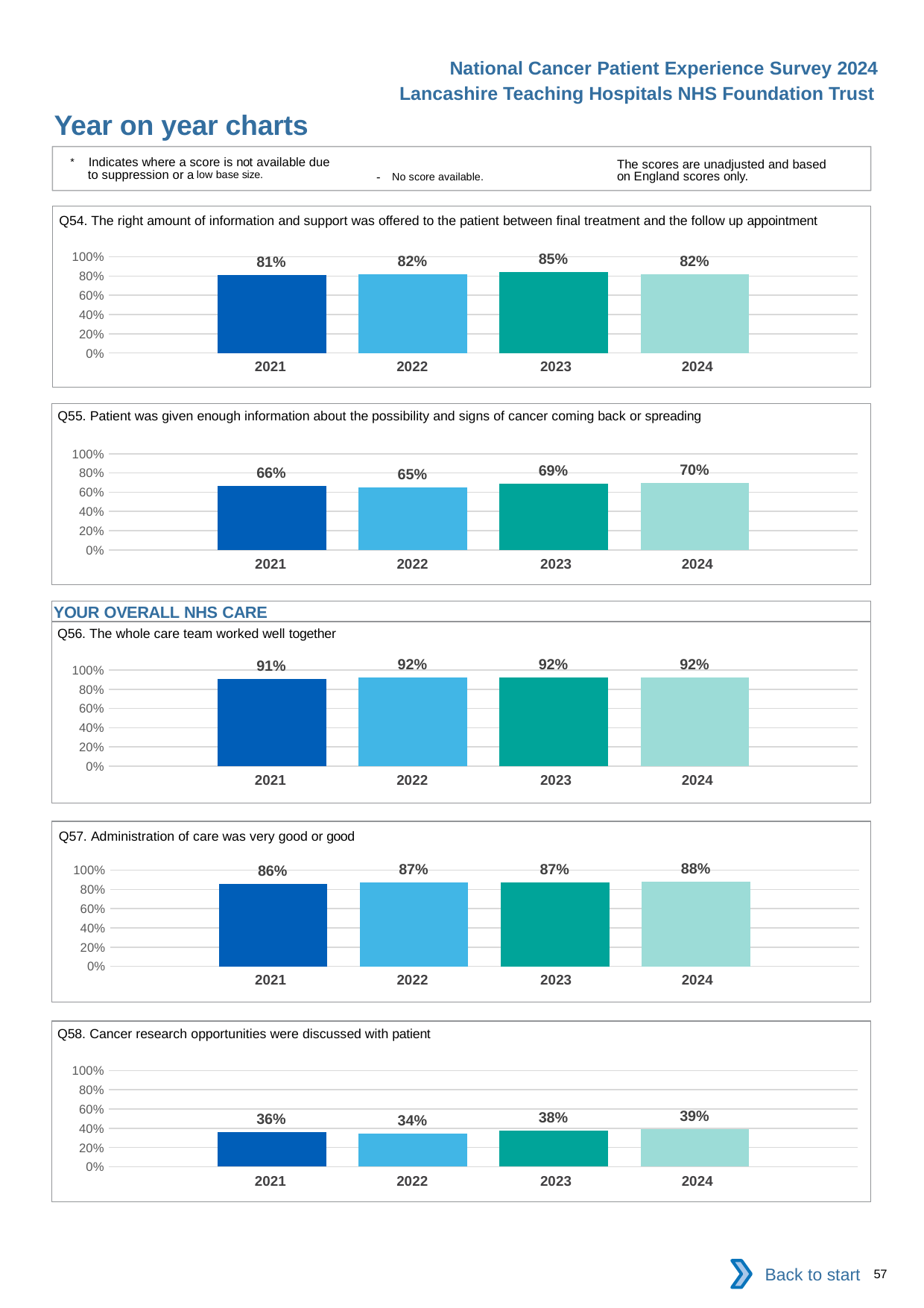
In the Q55 chart, which year has the lowest value? 2022 In the Q58 chart, which is larger, the value for 2021 or the value for 2023? 2023 In the Q57 chart, which year has the highest value? 2024 In the Q58 chart, what is the difference between the 2023 and 2022 values? 4% In the Q58 chart, is the value for 2024 greater or less than 40%? less What is the section heading shown above the Q56 chart? YOUR OVERALL NHS CARE What kind of chart is the Q57 chart? bar chart In the Q55 chart, what is the difference between the 2024 and 2021 values? 4% In the Q58 chart, what is the value for 2022? 34% How many years are shown in the Q54 chart? 4 In the Q56 chart, what is the value for 2021? 91% In the Q54 chart, what is the value for 2023? 85%